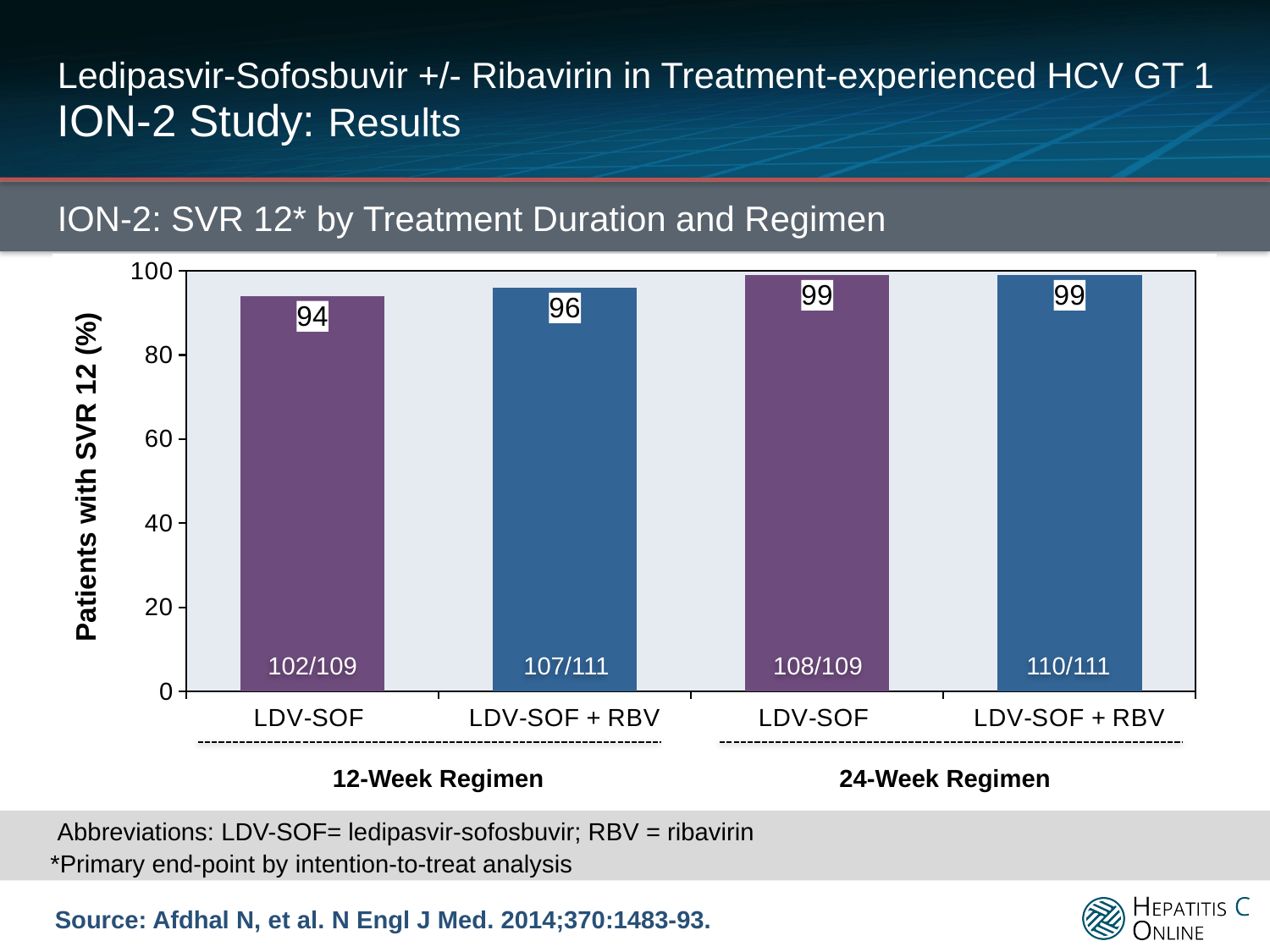
What is the SVR 12 rate for LDV-SOF + RBV in the 12-Week Regimen? 96 What fraction of patients is shown inside the LDV-SOF bar in the 12-Week Regimen? 102/109 What fraction of patients is shown inside the LDV-SOF + RBV bar in the 24-Week Regimen? 110/111 How many bars are plotted in the chart? 4 What kind of chart is shown on the slide? Bar chart Which bar has the lowest SVR 12 rate? LDV-SOF, 12-Week Regimen Which has a higher SVR 12 rate: LDV-SOF in the 12-Week Regimen or LDV-SOF + RBV in the 12-Week Regimen? LDV-SOF + RBV in the 12-Week Regimen What is the label of the y-axis? Patients with SVR 12 (%) What is the difference in SVR 12 rate between LDV-SOF + RBV and LDV-SOF in the 12-Week Regimen? 2 What is the SVR 12 rate for LDV-SOF in the 12-Week Regimen? 94 What is the SVR 12 rate for LDV-SOF in the 24-Week Regimen? 99 What is the difference in SVR 12 rate between LDV-SOF in the 24-Week Regimen and LDV-SOF in the 12-Week Regimen? 5